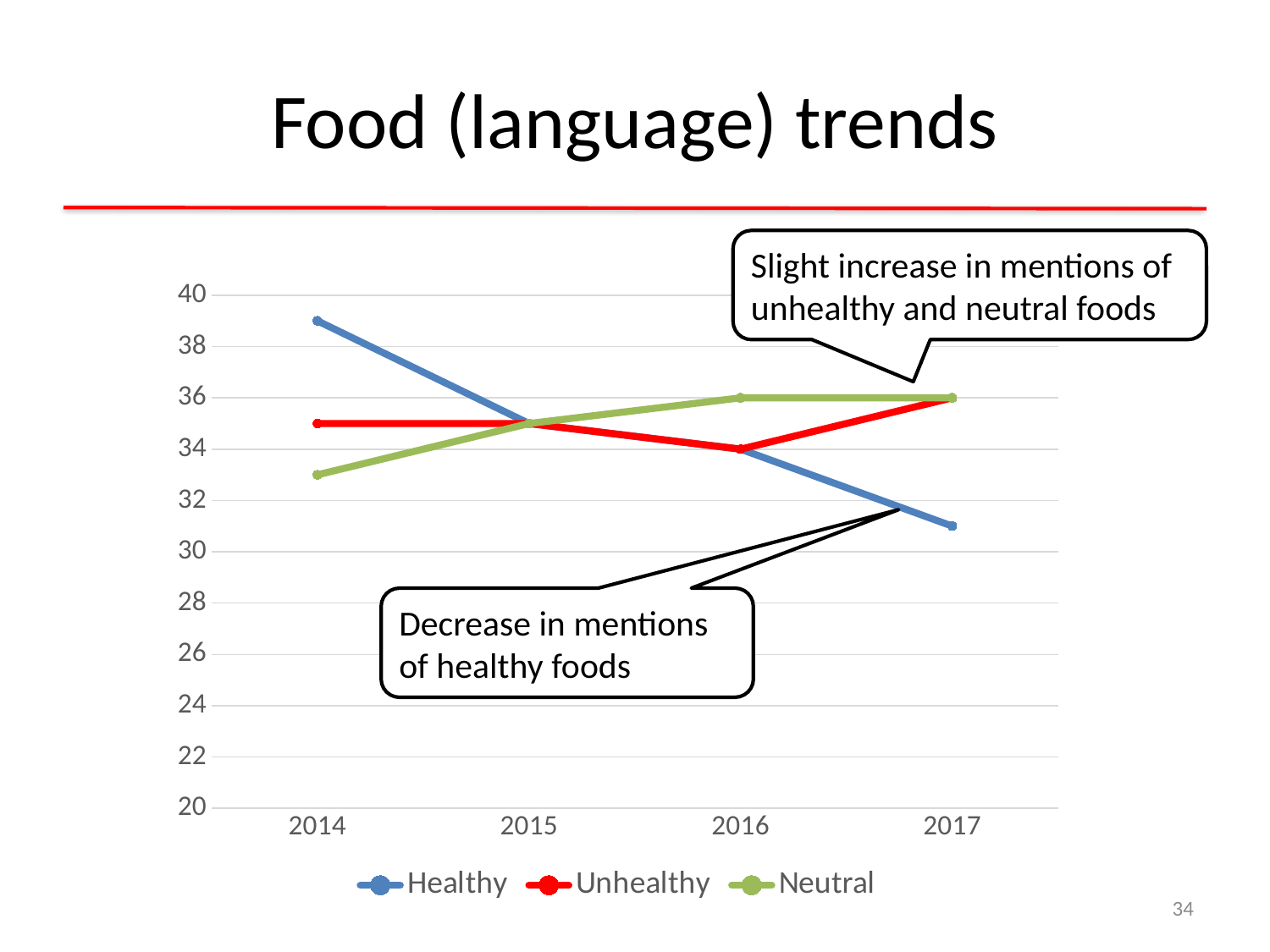
What kind of chart is shown on the slide? line chart Is the value for Healthy in 2014 greater or less than 38? greater What is the value for Unhealthy in 2016? 34 What is the value for Neutral in 2016? 36 Is the value for Neutral in 2014 greater or less than 34? less Which series has the lowest value in 2017? Healthy Is the value for Healthy in 2017 greater or less than 32? less How many years are shown on the x axis? 4 Does the Healthy series rise or fall from 2014 to 2017? fall How many series does the legend list? 3 What is the value for Unhealthy in 2017? 36 Which series has the highest value in 2014? Healthy